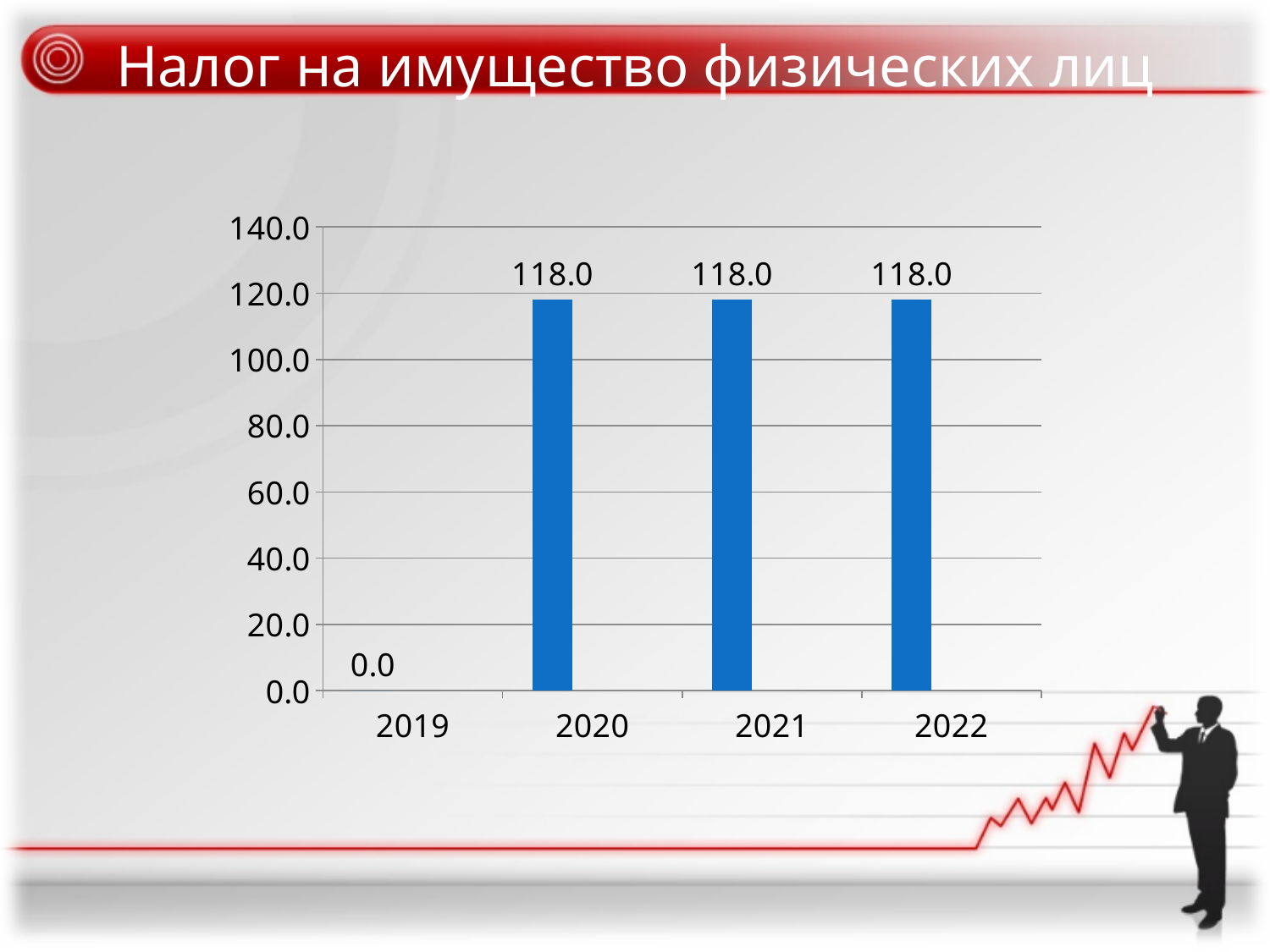
Which year has the lowest value? 2019 Which is larger, the value for 2019 or the value for 2020? 2020 What is the title of the slide? Налог на имущество физических лиц Is the value for 2021 greater or less than 100.0? greater What is the value for 2022? 118.0 What kind of chart is shown on the slide? bar chart What is the value for 2020? 118.0 How many years are shown on the x axis? 4 What is the value for 2019? 0.0 What is the highest value shown on the y axis? 140.0 What is the difference between the values for 2021 and 2019? 118.0 Do the values change between 2020 and 2022? No, they stay at 118.0